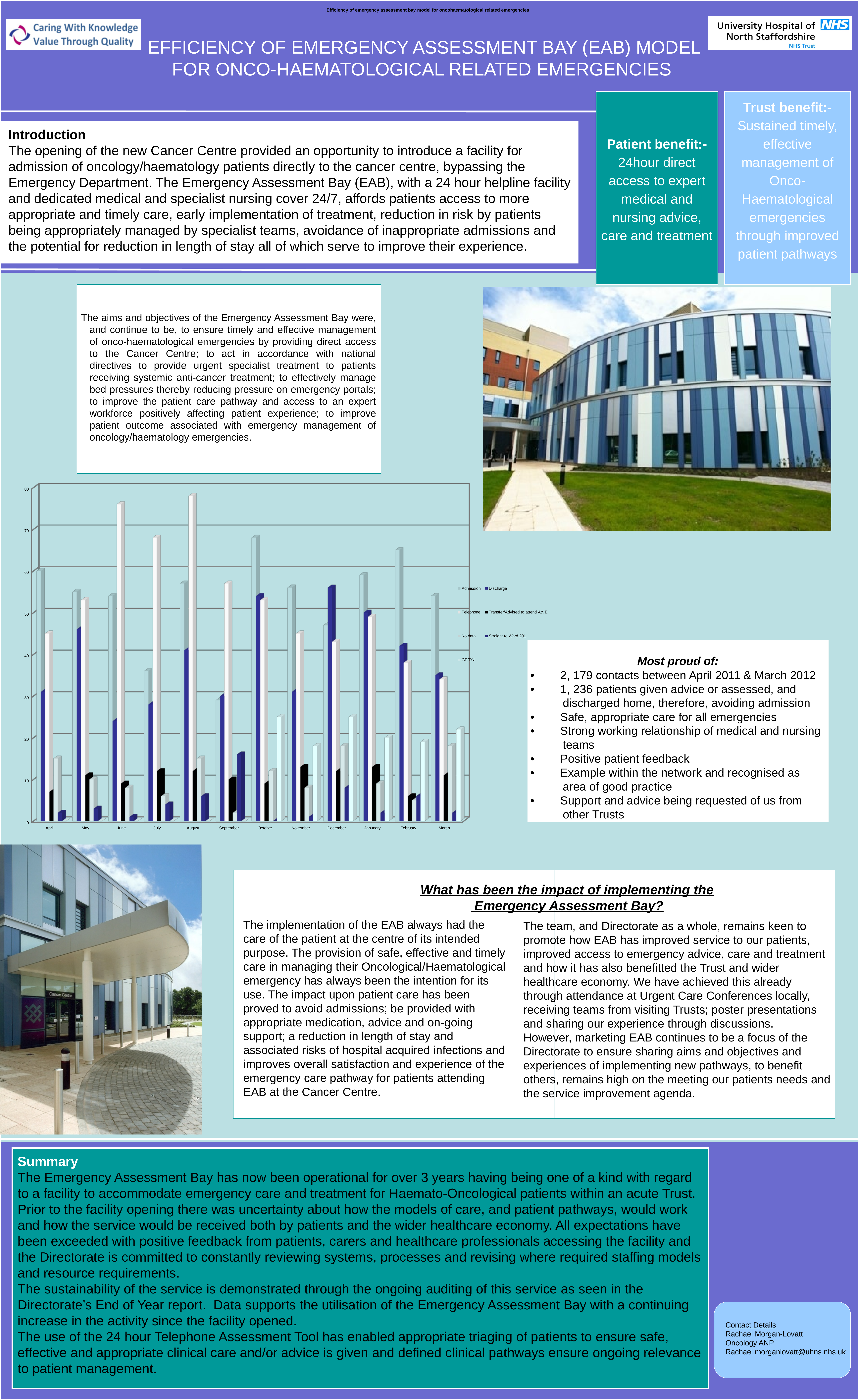
What kind of chart is shown on the slide? bar chart How many months are shown along the x axis of the chart? 12 How many series does the chart's legend list? 7 Is the tallest bar in April greater or less than 70? less What is the first category on the chart's x axis? April Is the tallest bar in May greater or less than 60? less Which month has the taller tallest bar, June or April? June Which month has the taller tallest bar, August or May? August Is the tallest bar in August greater or less than 70? greater What is the highest value shown on the chart's y axis? 80